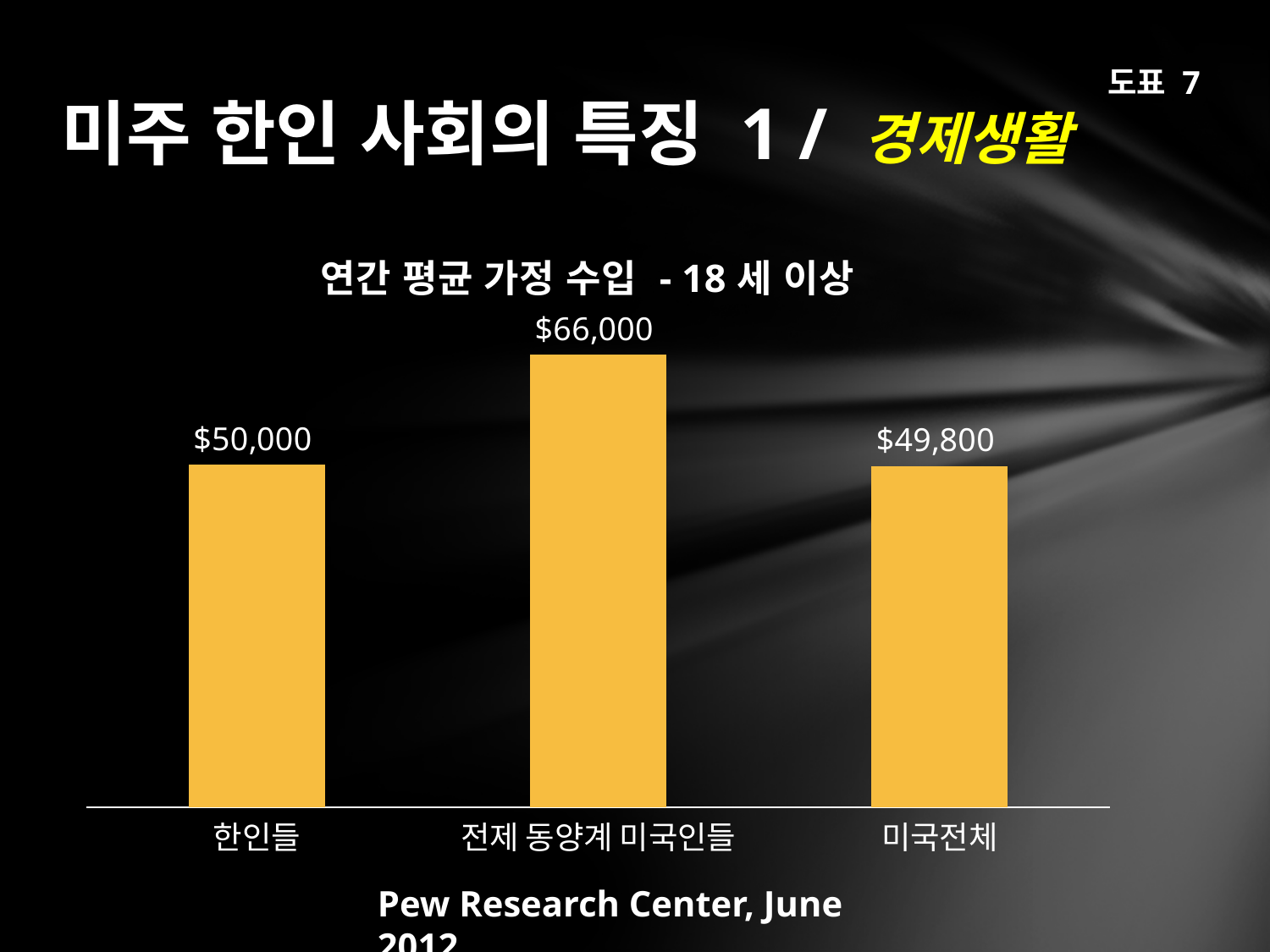
What is the annual average household income shown for 한인들? $50,000 Which category has the highest value in the chart? 전제 동양계 미국인들 What value is shown for 미국전체? $49,800 What value is shown for 전제 동양계 미국인들? $66,000 What kind of chart is shown on the slide? Bar chart What is the difference between the values for 한인들 and 미국전체? $200 What is the difference between the values for 전제 동양계 미국인들 and 한인들? $16,000 How many categories are shown in the chart? 3 What source is cited below the chart? Pew Research Center, June 2012 Which is larger, the value for 한인들 or the value for 전제 동양계 미국인들? 전제 동양계 미국인들 What is the title of the chart? 연간 평균 가정 수입 - 18 세 이상 Which category has the lowest value in the chart? 미국전체